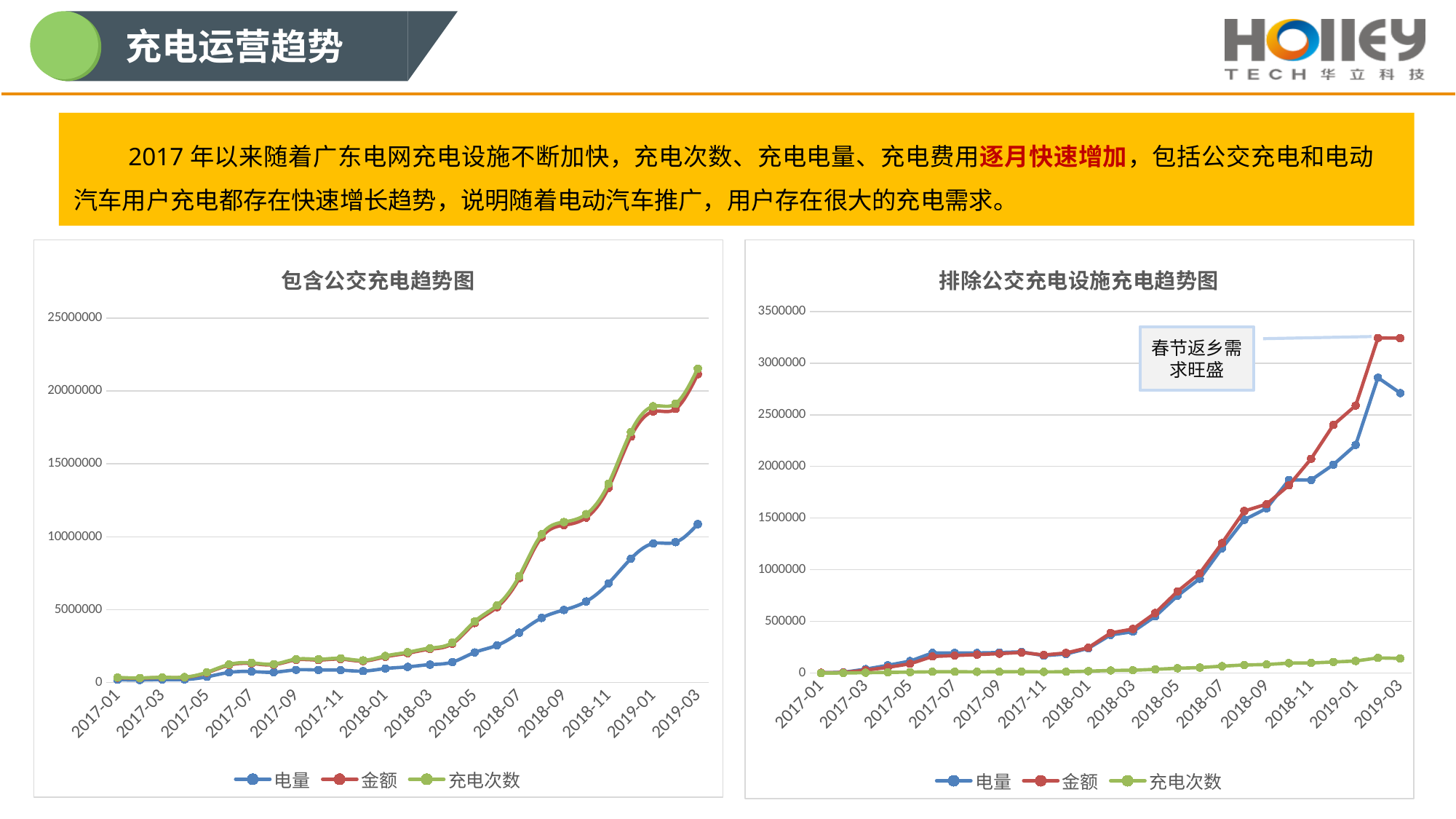
In the right chart (排除公交充电设施充电趋势图), which series reaches the highest value? 金额 What does the annotation box in the right chart (排除公交充电设施充电趋势图) say? 春节返乡需求旺盛 In the right chart (排除公交充电设施充电趋势图), is the value of 金额 at 2019-03 greater or less than 3000000? greater How many series does the legend of the right chart (排除公交充电设施充电趋势图) list? 3 In the right chart (排除公交充电设施充电趋势图), which series has the larger value at 2019-01, 电量 or 充电次数? 电量 In the left chart (包含公交充电趋势图), does the 金额 series generally rise or fall from 2017-01 to 2019-03? rise In the left chart (包含公交充电趋势图), is the value of 电量 at 2019-03 greater or less than 10000000? greater What is the title of the right chart? 排除公交充电设施充电趋势图 In the right chart (排除公交充电设施充电趋势图), is the value of 充电次数 at 2019-03 greater or less than 500000? less What kind of chart is the left chart titled 包含公交充电趋势图? line chart